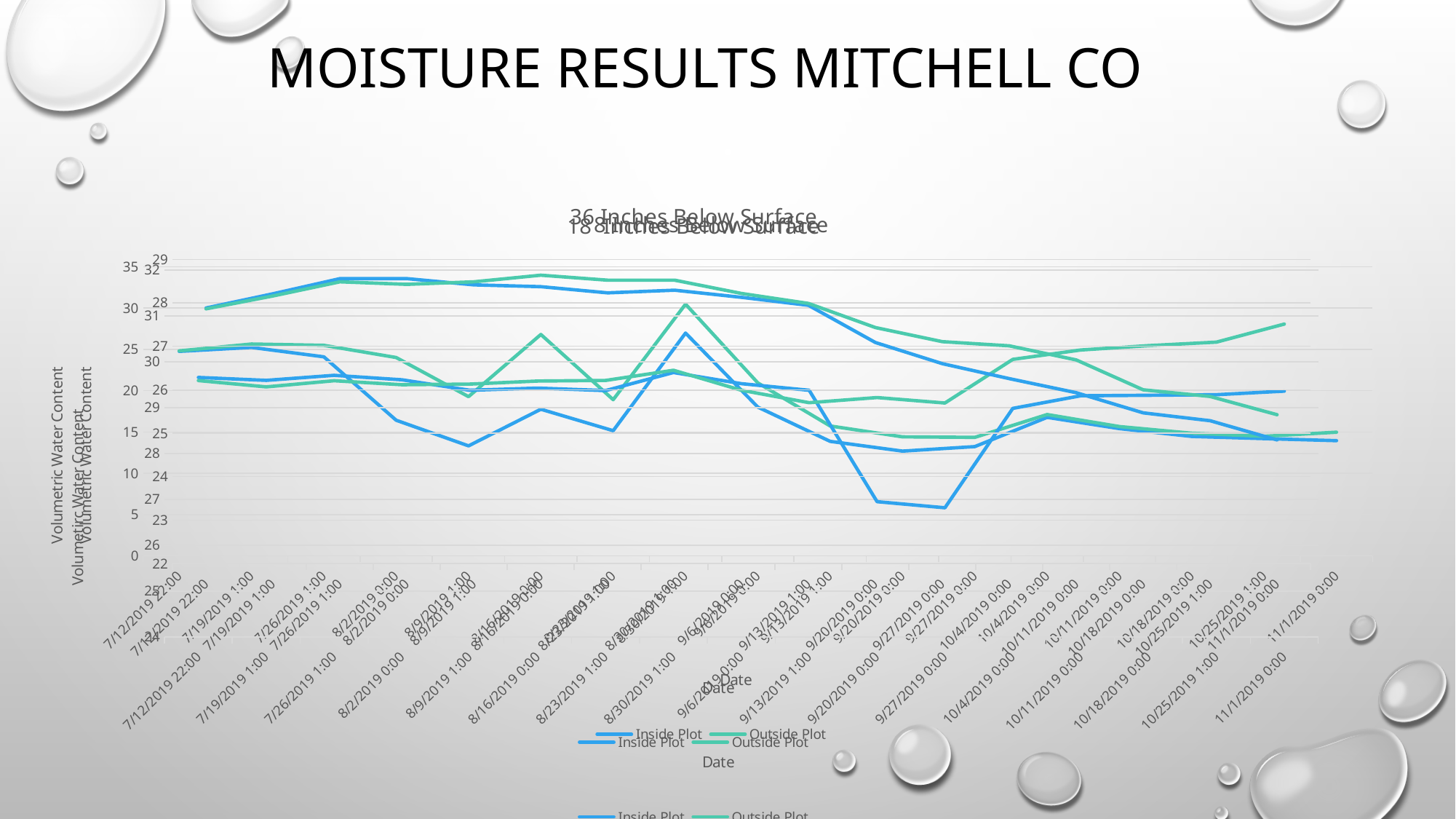
What are the two series named in the legend of the "36 Inches Below Surface" chart? Inside Plot and Outside Plot What is the first date shown on the x axis of the "36 Inches Below Surface" chart? 7/12/2019 22:00 What is the last date shown on the x axis of the "36 Inches Below Surface" chart? 11/1/2019 0:00 What is the title of the y axis on the "36 Inches Below Surface" chart? Volumetric Water Content How many dates are labelled along the x axis of the "36 Inches Below Surface" chart? 17 What kind of chart is used on this slide to show the moisture results? Line chart How many series does the legend of the "36 Inches Below Surface" chart list? 2